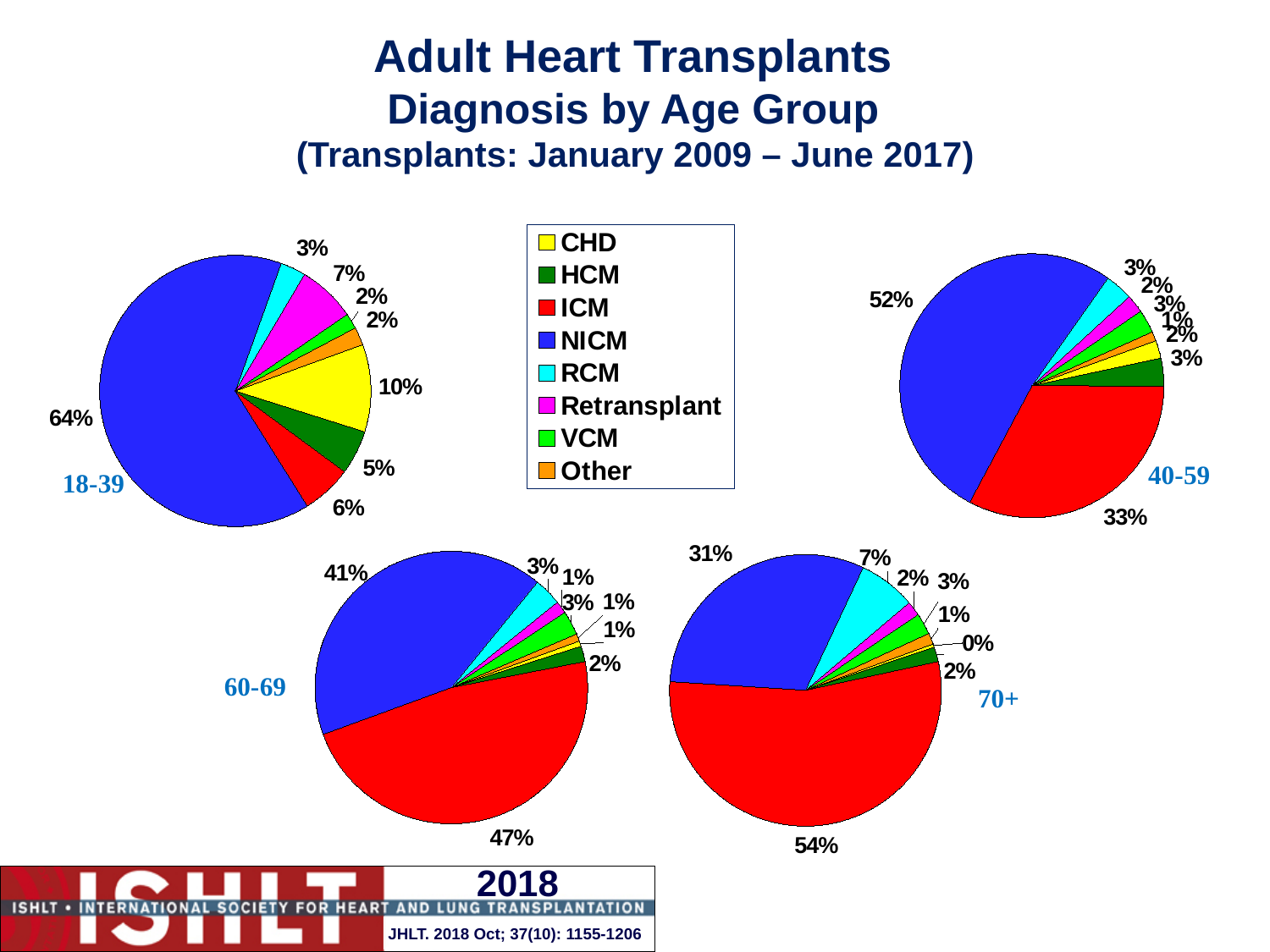
In the 60-69 pie chart, what percentage is ICM? 47% In the 40-59 pie chart, what percentage is ICM? 33% How many diagnosis categories does the legend list? 8 In the 40-59 pie chart, what is the difference between the NICM share and the ICM share? 19% In the 18-39 pie chart, what share of transplants is NICM? 64% What type of chart is used to show diagnosis by age group on this slide? Pie chart In the 18-39 pie chart, which diagnosis has the largest share? NICM In the 70+ pie chart, what percentage is RCM? 7% In the 18-39 pie chart, what percentage is CHD? 10% In the 60-69 pie chart, which is larger, NICM or ICM? ICM In the 70+ pie chart, what is the difference between the ICM share and the NICM share? 23% In the 70+ pie chart, which diagnosis has the largest share? ICM